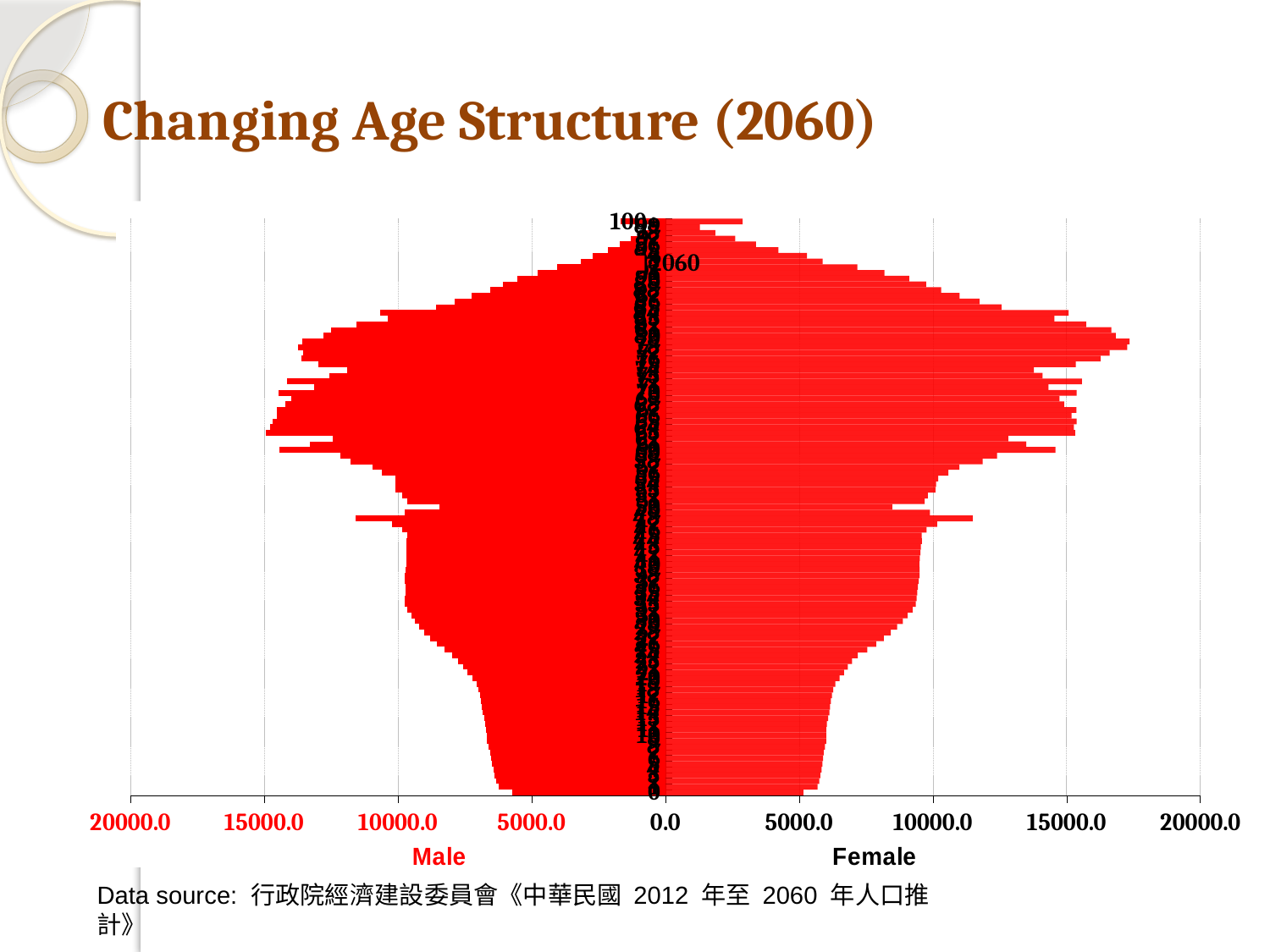
Which group is plotted on the left side of the chart? Male What is the title of the chart? Changing Age Structure (2060) Which is larger, the Male value at age 0 or the Male value at age 100? age 0 Is the longest Male bar greater or less than 10000.0? greater Is the Male value at age 100 greater or less than 5000.0? less What kind of chart is shown on the slide? bar chart Which is larger, the Female value at age 0 or the Female value at age 100? age 0 Is the Female value at age 0 greater or less than 10000.0? less What is the largest value shown on the horizontal axis? 20000.0